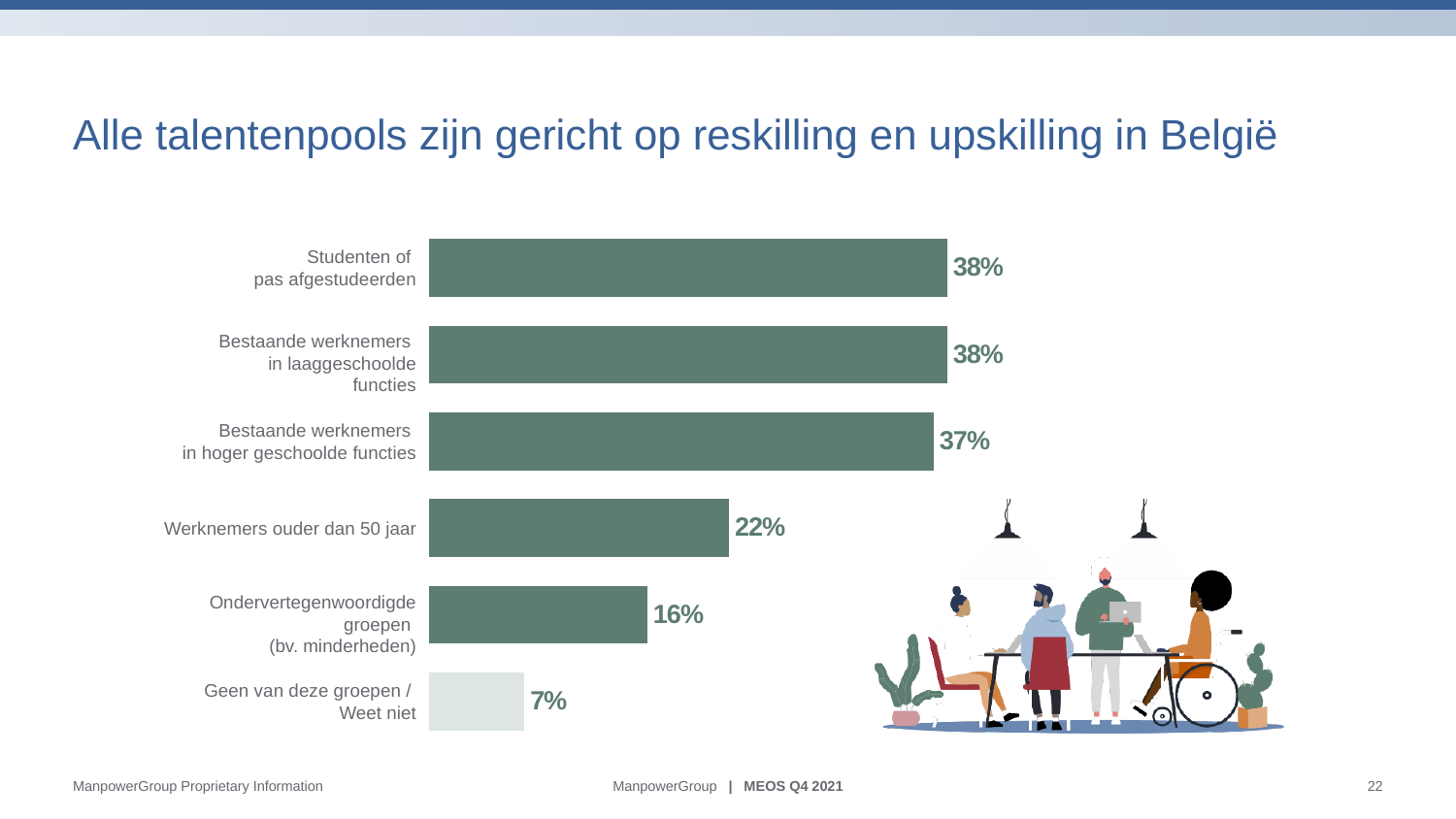
What is the difference between the values for 'Werknemers ouder dan 50 jaar' and 'Ondervertegenwoordigde groepen (bv. minderheden)'? 6% Which is larger: the value for 'Werknemers ouder dan 50 jaar' or the value for 'Geen van deze groepen / Weet niet'? Werknemers ouder dan 50 jaar Which bar is shown in a lighter colour than the others? Geen van deze groepen / Weet niet What is the value for 'Werknemers ouder dan 50 jaar'? 22% What is the value for 'Ondervertegenwoordigde groepen (bv. minderheden)'? 16% What kind of chart is shown on the slide? Bar chart What is the value for 'Geen van deze groepen / Weet niet'? 7% How many categories are shown in the chart? 6 What is the value for 'Bestaande werknemers in hoger geschoolde functies'? 37% What is the title of the slide? Alle talentenpools zijn gericht op reskilling en upskilling in België What is the difference between the values for 'Studenten of pas afgestudeerden' and 'Werknemers ouder dan 50 jaar'? 16% Which category has the lowest value? Geen van deze groepen / Weet niet